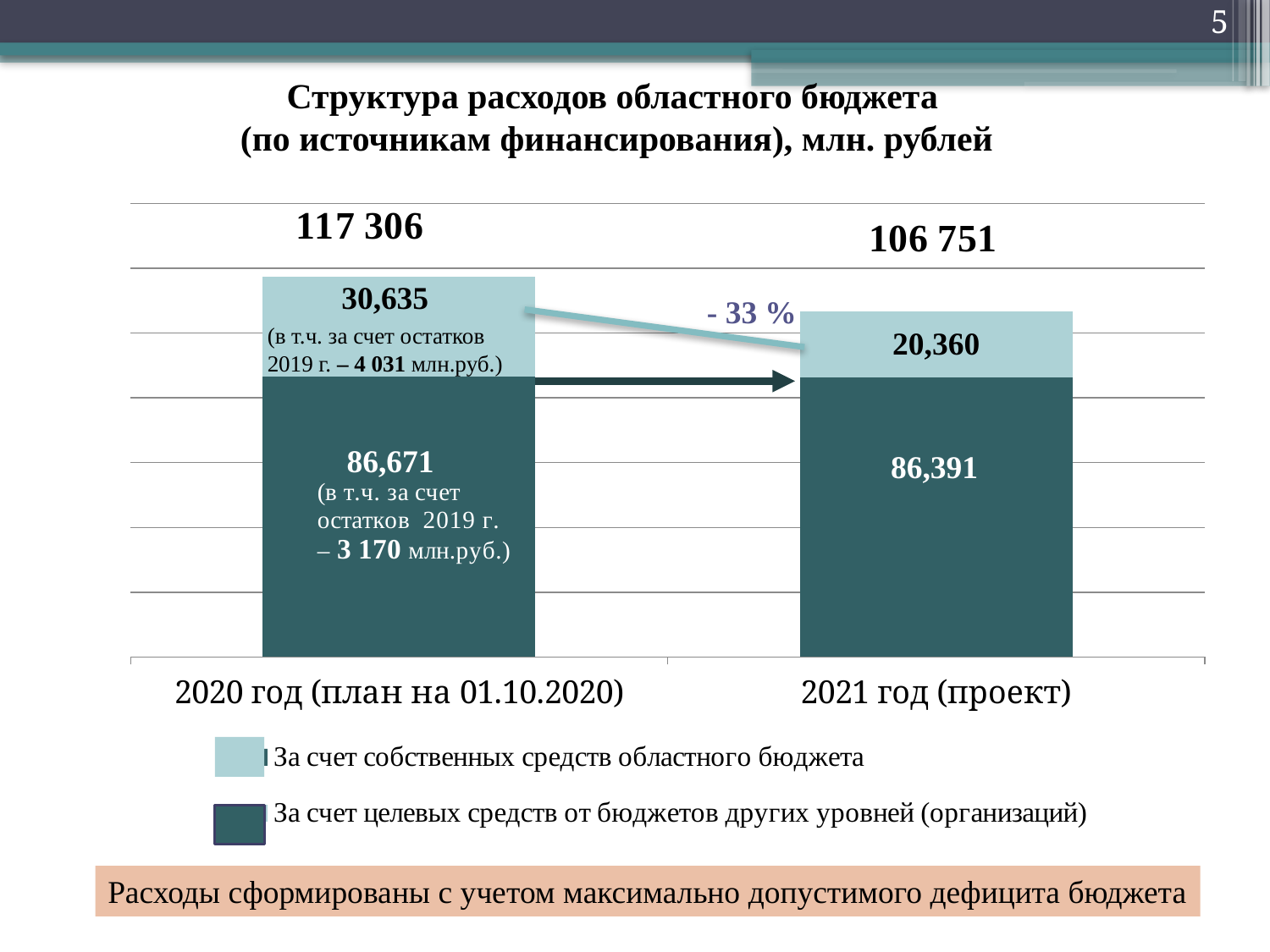
What kind of chart is shown on the slide? Stacked bar chart How many categories (years) are shown on the x axis of the chart? 2 By how much does the value for 'За счет собственных средств областного бюджета' differ between 2020 and 2021? 10,275 Does the total of the stacked bars rise or fall from 2020 to 2021? Fall What is the value for 'За счет целевых средств от бюджетов других уровней (организаций)' in 2020 год (план на 01.10.2020)? 86,671 How many series does the chart legend list? 2 What is the total of the stacked bar for 2021 год (проект)? 106 751 What is the value for 'За счет собственных средств областного бюджета' in 2020 год (план на 01.10.2020)? 30,635 What is the value for 'За счет целевых средств от бюджетов других уровней (организаций)' in 2021 год (проект)? 86,391 What percentage change is printed on the arrow between the 2020 and 2021 bars? - 33 % What is the total of the stacked bar for 2020 год (план на 01.10.2020)? 117 306 What is the value for 'За счет собственных средств областного бюджета' in 2021 год (проект)? 20,360